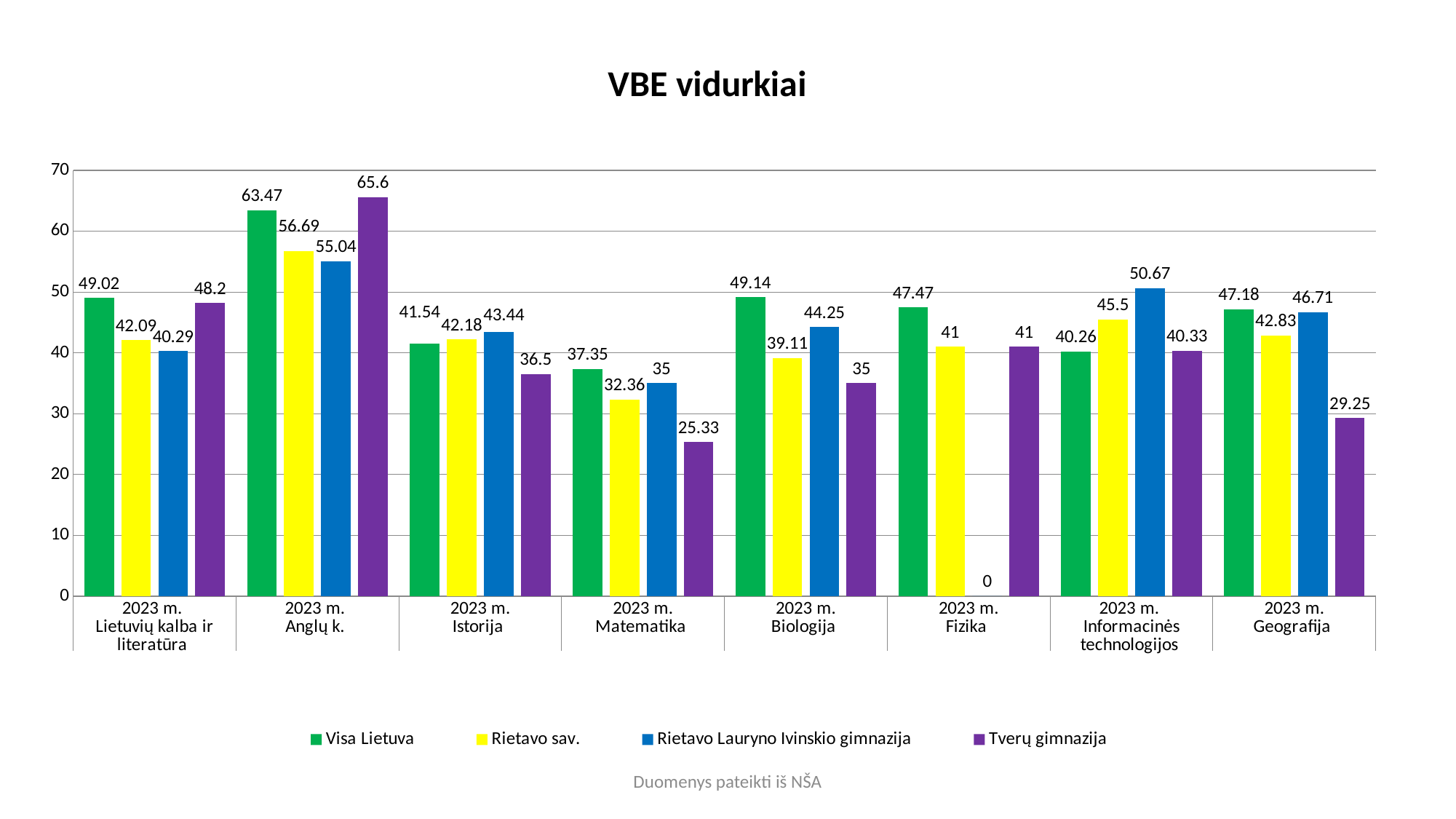
What is the difference between the Tverų gimnazija and Visa Lietuva values in 2023 m. Anglų k.? 2.13 What is the value for Rietavo Lauryno Ivinskio gimnazija in 2023 m. Informacinės technologijos? 50.67 Is the value for Tverų gimnazija in 2023 m. Geografija greater or less than 30? less Which subject has the lowest value for Visa Lietuva? 2023 m. Matematika How many series does the legend list? 4 Which subject has the highest value for Tverų gimnazija? 2023 m. Anglų k. How many subject categories are shown on the x axis? 8 What is the value for Rietavo Lauryno Ivinskio gimnazija in 2023 m. Fizika? 0 Which is larger in 2023 m. Biologija: Rietavo sav. or Rietavo Lauryno Ivinskio gimnazija? Rietavo Lauryno Ivinskio gimnazija What is the value for Tverų gimnazija in 2023 m. Matematika? 25.33 What type of chart is shown on the slide? bar chart What is the value for Visa Lietuva in 2023 m. Anglų k.? 63.47